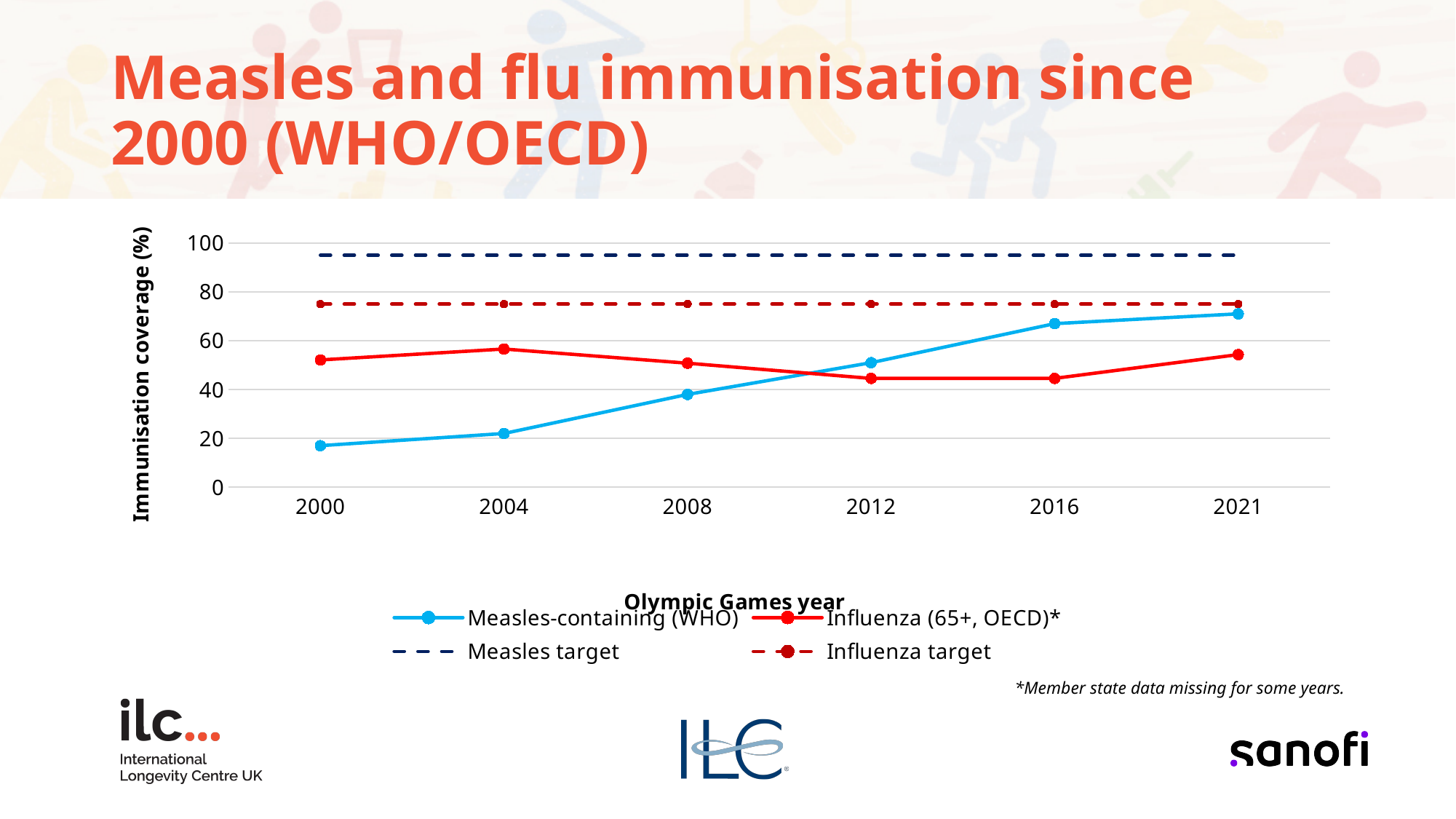
In which year is the Measles-containing (WHO) coverage lowest? 2000 Is the Measles-containing (WHO) value for 2016 greater or less than 60? greater What kind of chart is shown on the slide? Line chart How many Olympic Games years are plotted along the x axis? 6 Is the Influenza (65+, OECD) value for 2004 greater or less than 60? less In 2021, which is larger: Measles-containing (WHO) coverage or Influenza (65+, OECD) coverage? Measles-containing (WHO) How many series does the legend list? 4 Does the Measles-containing (WHO) coverage rise or fall from 2000 to 2021? Rise Is the Influenza target line greater or less than 80? less In 2000, which is larger: Measles-containing (WHO) coverage or Influenza (65+, OECD) coverage? Influenza (65+, OECD) In which year is the Measles-containing (WHO) coverage highest? 2021